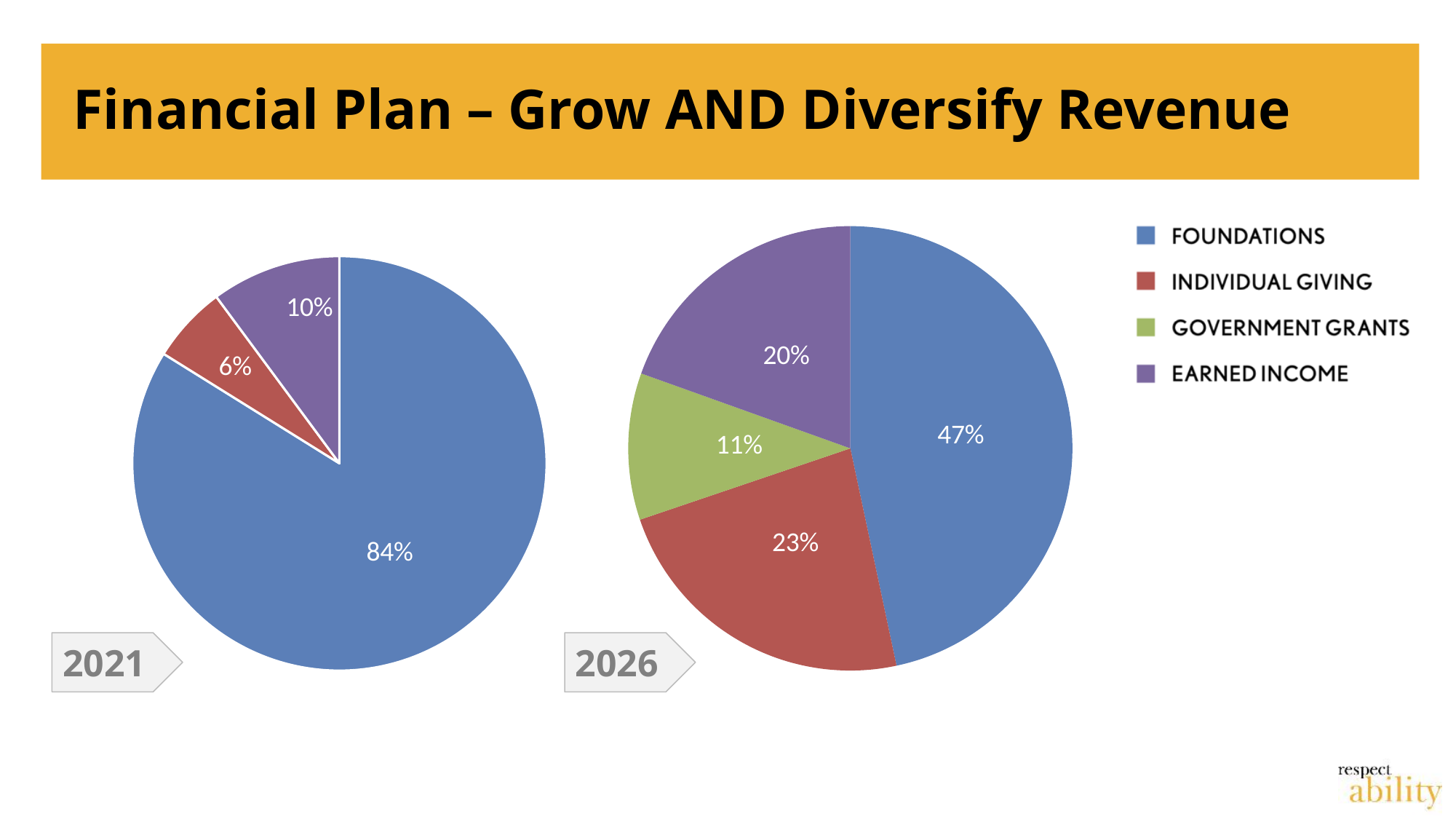
In the 2021 pie chart, which category has the smallest share? Individual Giving In the 2026 pie chart, which category has the smallest share? Government Grants How many slices does the 2021 pie chart have? 3 How many categories does the legend list? 4 What type of chart is used on this slide? Pie chart In the 2021 pie chart, what share of revenue comes from Earned Income? 10% What is the difference between the Foundations share in the 2021 chart and the Foundations share in the 2026 chart? 37% In the 2026 pie chart, which is larger: Earned Income or Individual Giving? Individual Giving In the 2021 pie chart, what share of revenue comes from Foundations? 84% In the 2026 pie chart, what share of revenue comes from Government Grants? 11% In the 2026 pie chart, what share of revenue comes from Individual Giving? 23% In the 2026 pie chart, which category has the largest share? Foundations